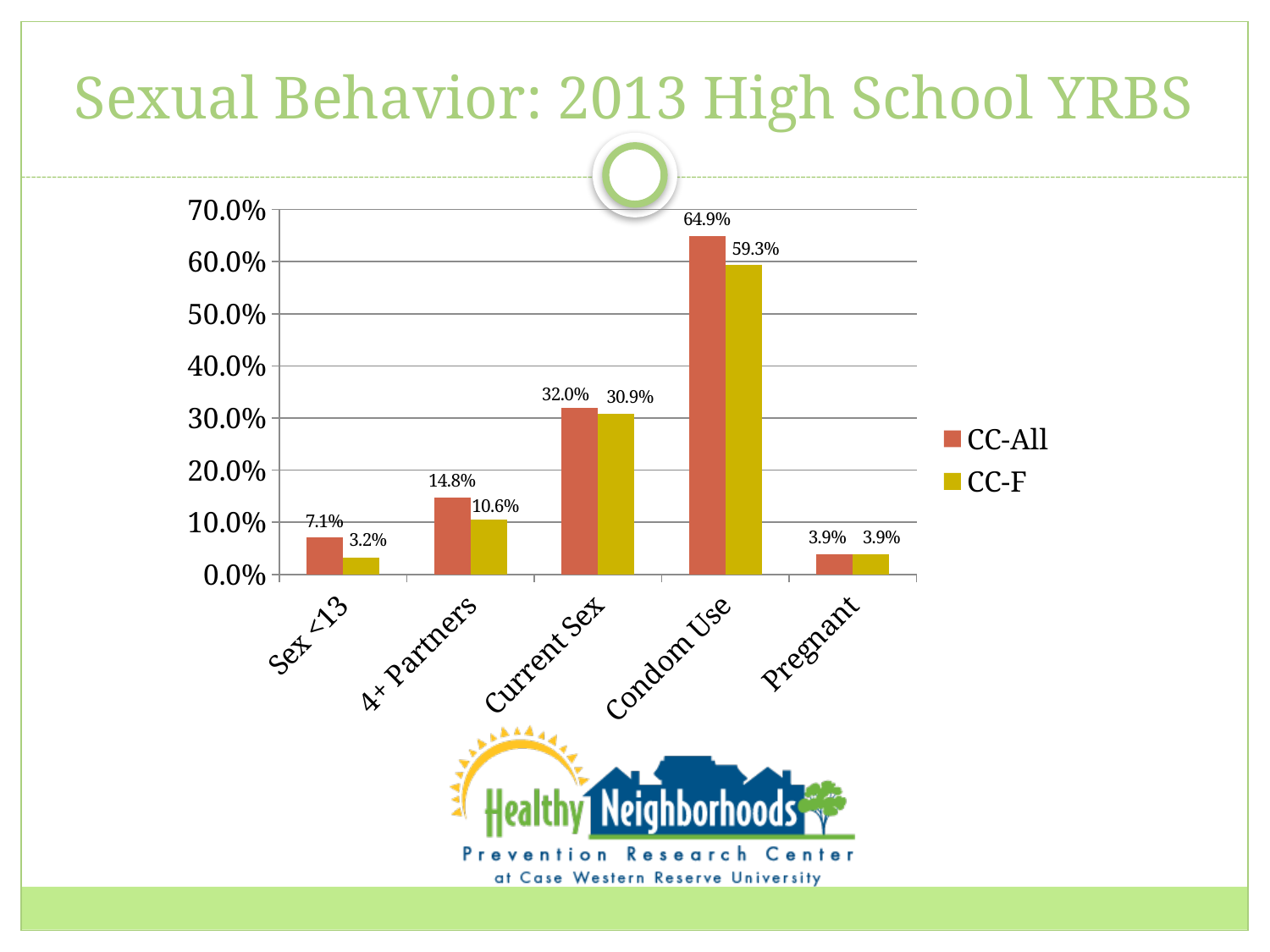
What is the difference between the CC-All and CC-F values for Condom Use? 5.6% What is the CC-F value for 4+ Partners? 10.6% How many categories are shown on the x axis? 5 What is the CC-F value for Sex <13? 3.2% What is the title of the slide? Sexual Behavior: 2013 High School YRBS Which is larger for Current Sex, the CC-All value or the CC-F value? CC-All What kind of chart is shown on the slide? Bar chart What is the CC-All value for Condom Use? 64.9% Which category has the highest CC-All value? Condom Use How many series does the legend list? 2 Which category has the lowest CC-F value? Sex <13 Is the CC-F value for Condom Use greater or less than 50.0%? greater